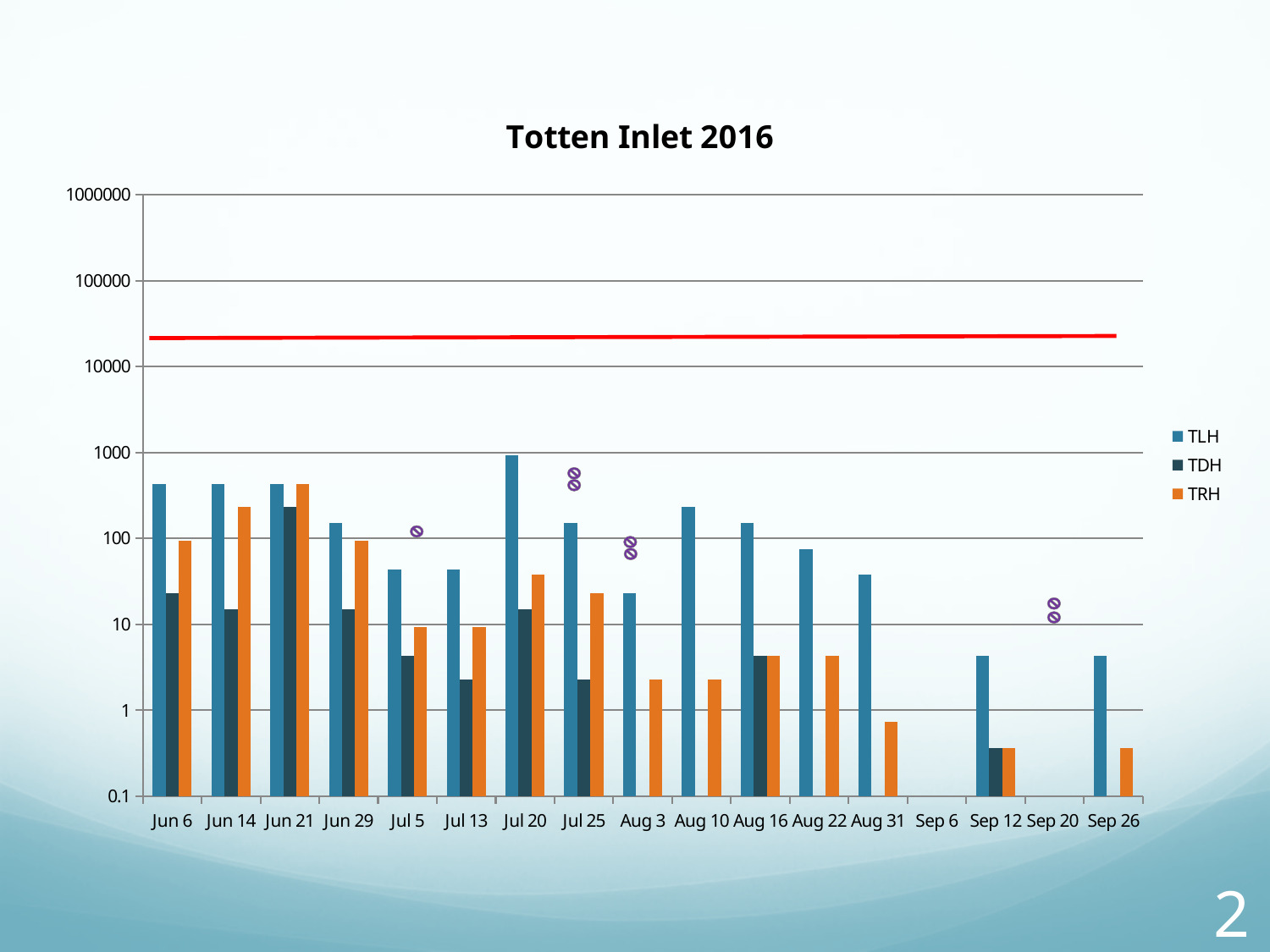
On which date is the TRH value highest? Jun 21 Which is larger on Jun 6, the TLH value or the TDH value? TLH On which date is the TLH value highest? Jul 20 Which series are listed in the legend? TLH, TDH, TRH What kind of chart is shown on the slide? bar chart How many series does the legend list? 3 How many dates are shown on the x axis? 17 What is the title of the chart? Totten Inlet 2016 On which date is the TDH value highest? Jun 21 Is the TLH value for Jul 20 greater or less than 100? greater Is the TDH value for Jul 5 greater or less than 10? less